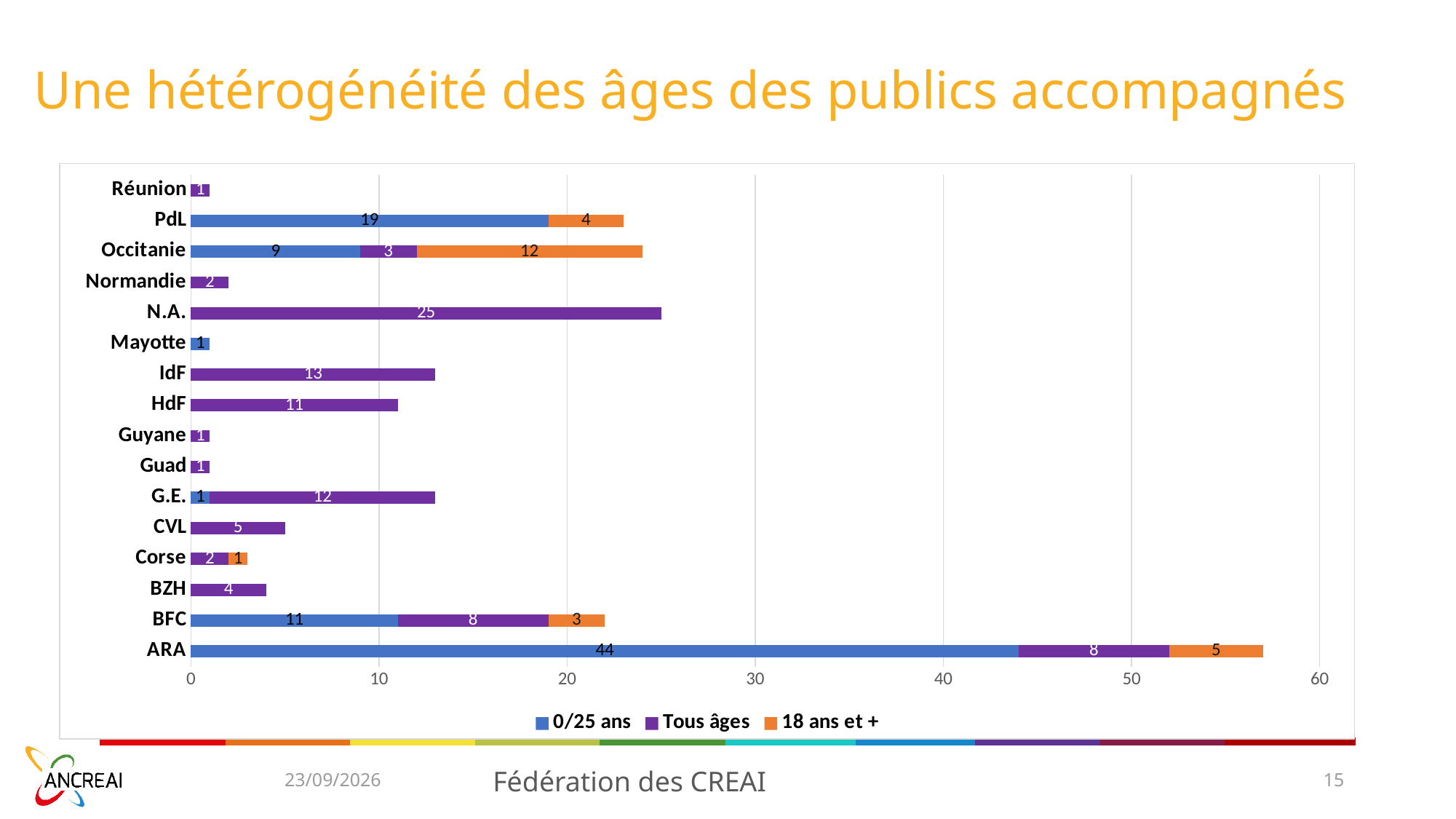
What is the value of the '18 ans et +' series for Occitanie? 12 Which is larger: the 'Tous âges' value for IdF or the 'Tous âges' value for HdF? IdF What is the total of the stacked bar for ARA? 57 What is the value of the '0/25 ans' series for ARA? 44 What is the value of the 'Tous âges' series for N.A.? 25 What is the difference between the '0/25 ans' value for PdL and the '0/25 ans' value for Occitanie? 10 How many series does the legend list? 3 What is the total of the stacked bar for BFC? 22 Which region has the longest total bar? ARA Which series is shown in orange in the legend? 18 ans et + What type of chart is shown on the slide? stacked bar chart How many regions (categories) are shown on the chart? 16